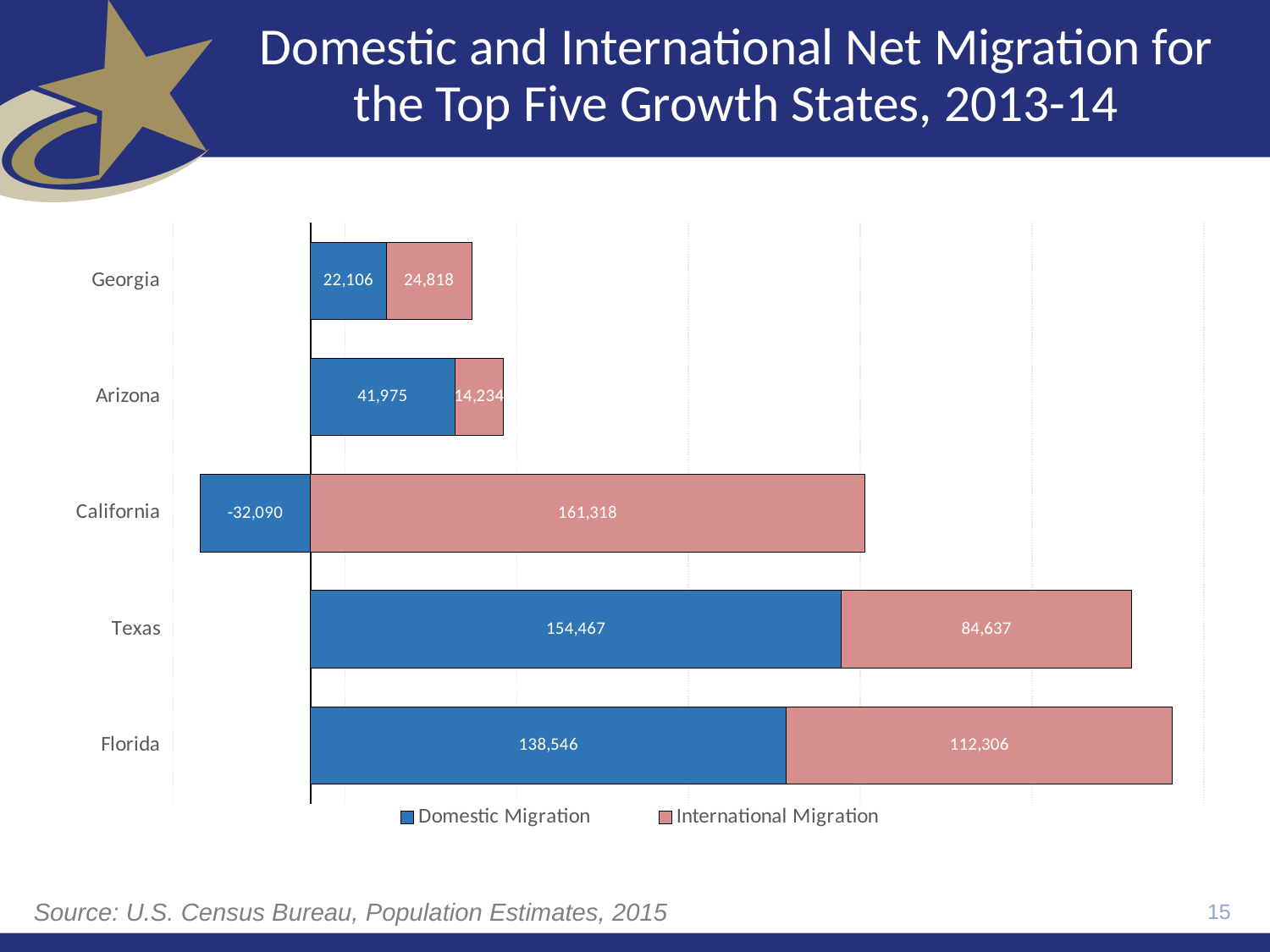
What is the Domestic Migration value for California? -32,090 What is the difference between the Domestic Migration values for Texas and Florida? 15,921 What is the total of the Domestic and International Migration values for Florida? 250,852 How many series does the legend list? 2 Which state has the lowest Domestic Migration value? California Which state has the highest International Migration value? California What kind of chart is shown on the slide? Stacked bar chart What is the International Migration value for Arizona? 14,234 What is the Domestic Migration value for Texas? 154,467 What is the International Migration value for California? 161,318 How many states are shown on the chart? 5 Which is larger, the International Migration value for Florida or for Texas? Florida